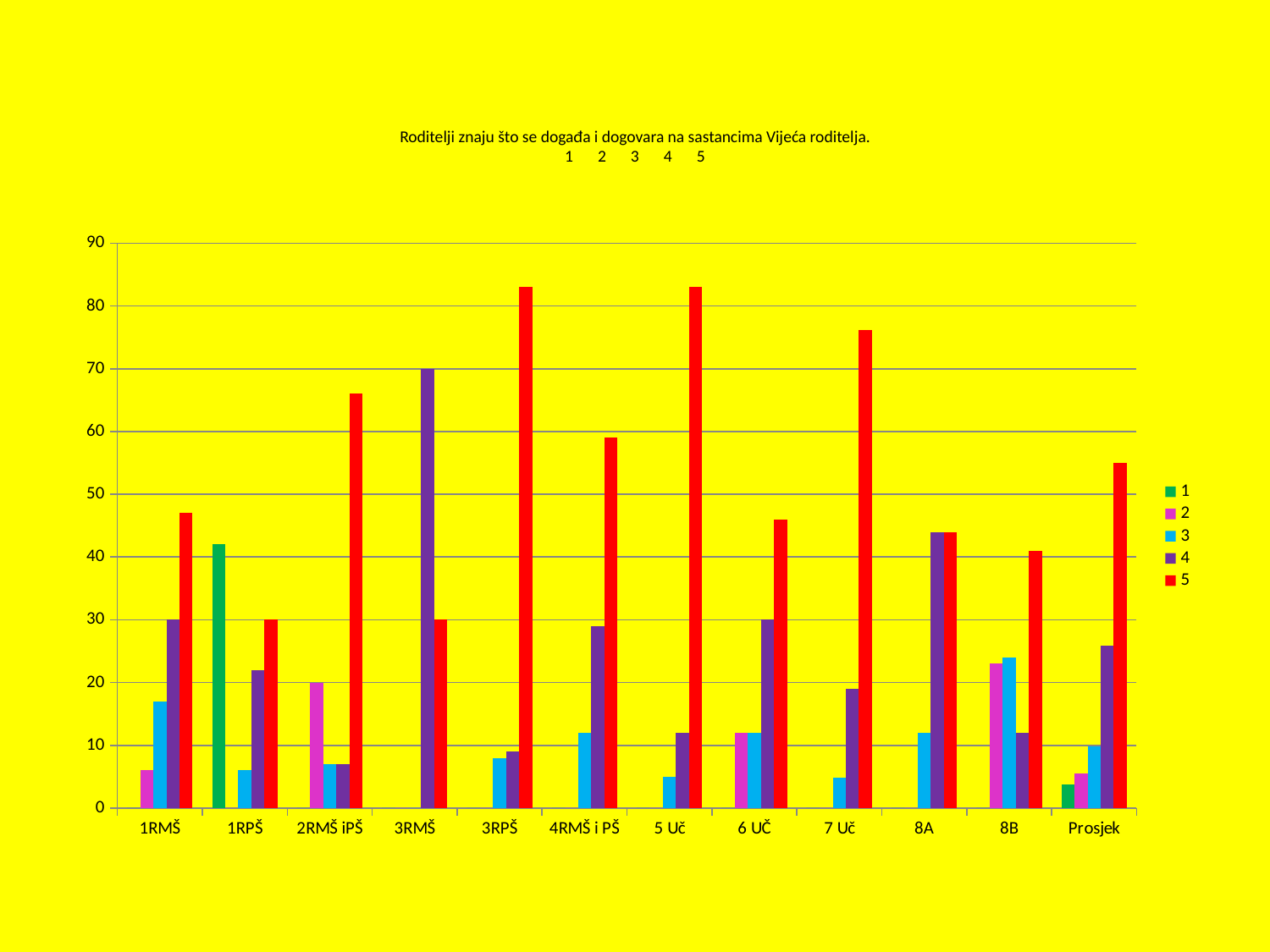
How many series does the legend list? 5 What is the title of the chart? Roditelji znaju što se događa i dogovara na sastancima Vijeća roditelja. Which series has the highest value for 1RMŠ? 5 Is the value of series 5 for 7 Uč greater or less than 70? greater How many categories are shown along the x axis? 12 What is the value of series 4 for 3RMŠ? 70 For 1RPŠ, which is larger: series 1 or series 5? series 1 Which has the larger series 5 value: 2RMŠ iPŠ or 4RMŠ i PŠ? 2RMŠ iPŠ What is the value of series 4 for 1RMŠ? 30 Is the value of series 5 for 3RPŠ greater or less than 80? greater What kind of chart is shown on the slide? bar chart Is the value of series 5 for Prosjek greater or less than 50? greater